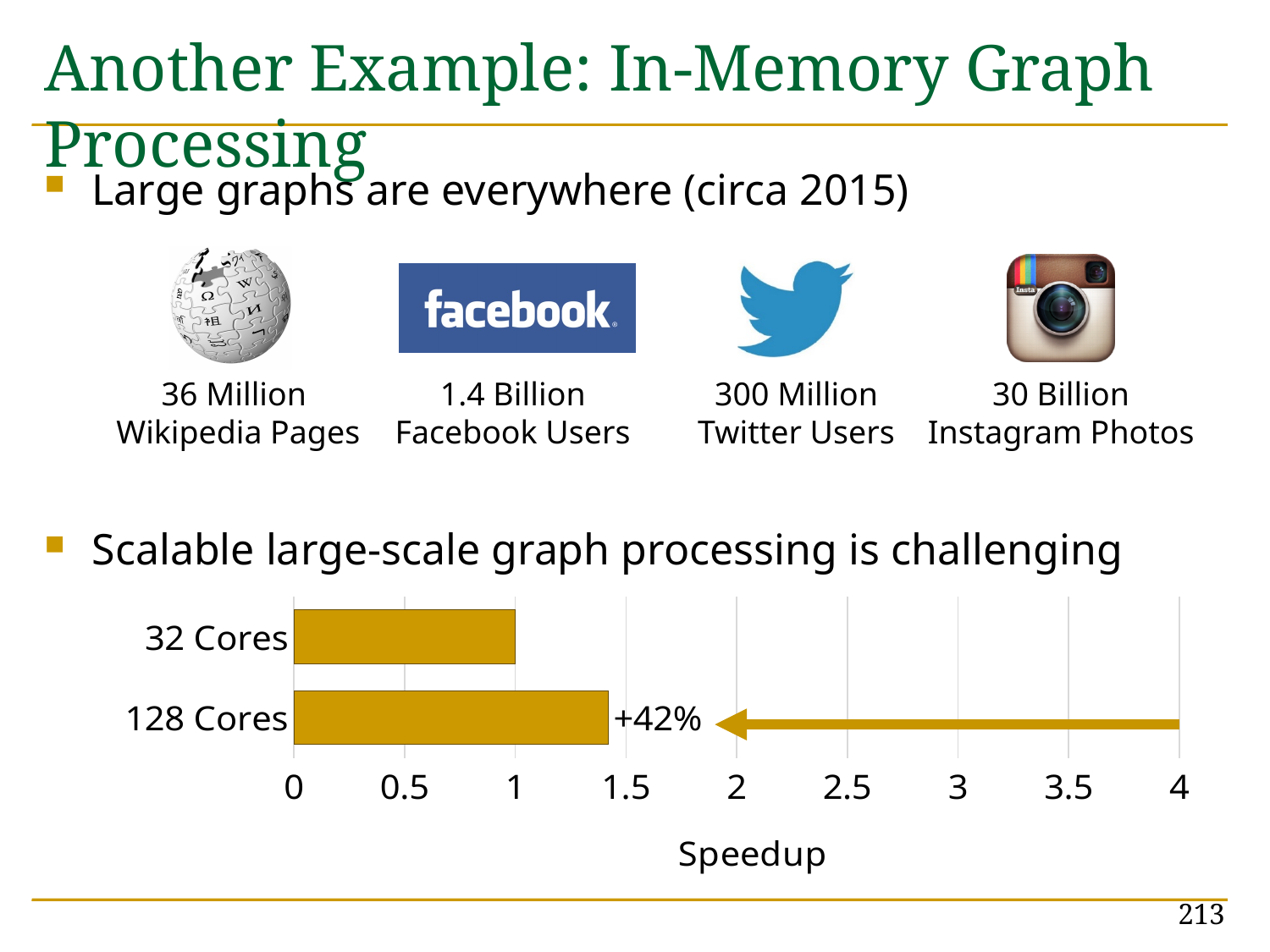
What annotation is printed next to the 128 Cores bar? +42% What is the speedup value for 32 Cores? 1 How many categories are plotted in the chart? 2 What is the title of the horizontal axis of the chart? Speedup Is the speedup for 128 Cores greater or less than 2? less What kind of chart is shown on the slide? bar chart Is the speedup for 128 Cores greater or less than 1? greater Is the speedup for 128 Cores greater or less than 1.5? less Which has a larger speedup, 32 Cores or 128 Cores? 128 Cores Which category has the highest speedup? 128 Cores Which category has the lowest speedup? 32 Cores